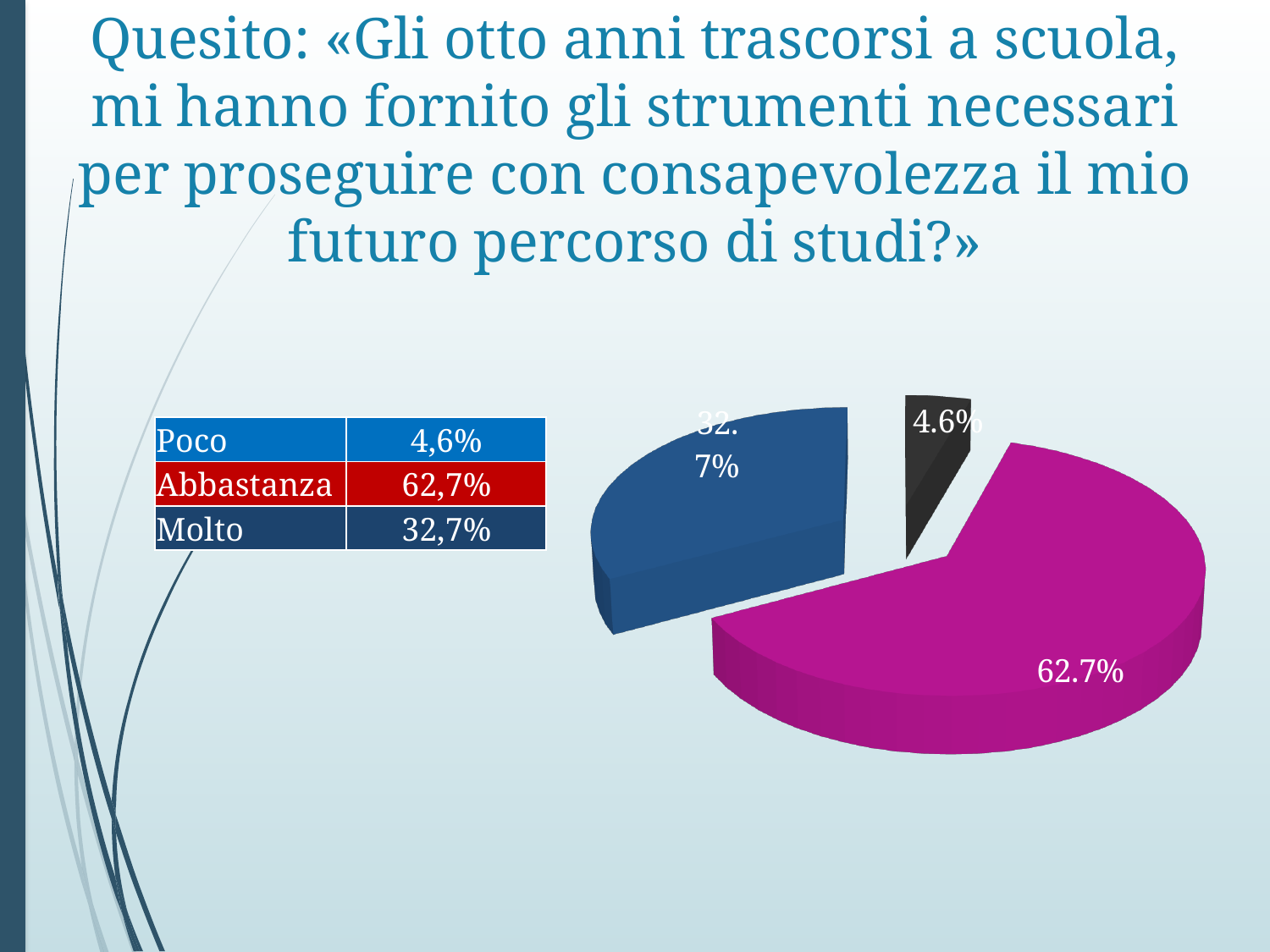
What is the difference in percentage points between "Molto" and "Poco"? 28,1 percentage points What percentage of respondents answered "Abbastanza"? 62,7% What colour is the largest slice of the pie chart? Magenta Which response category has the smallest share in the pie chart? Poco What percentage of respondents answered "Molto"? 32,7% What share of the pie does the largest slice represent? 62.7% What percentage of respondents answered "Poco"? 4,6% Which is larger, the share for "Molto" or the share for "Poco"? Molto Which response category has the largest share in the pie chart? Abbastanza What is the difference in percentage points between "Abbastanza" and "Molto"? 30 percentage points How many slices does the pie chart have? 3 What kind of chart is shown on the slide? Pie chart